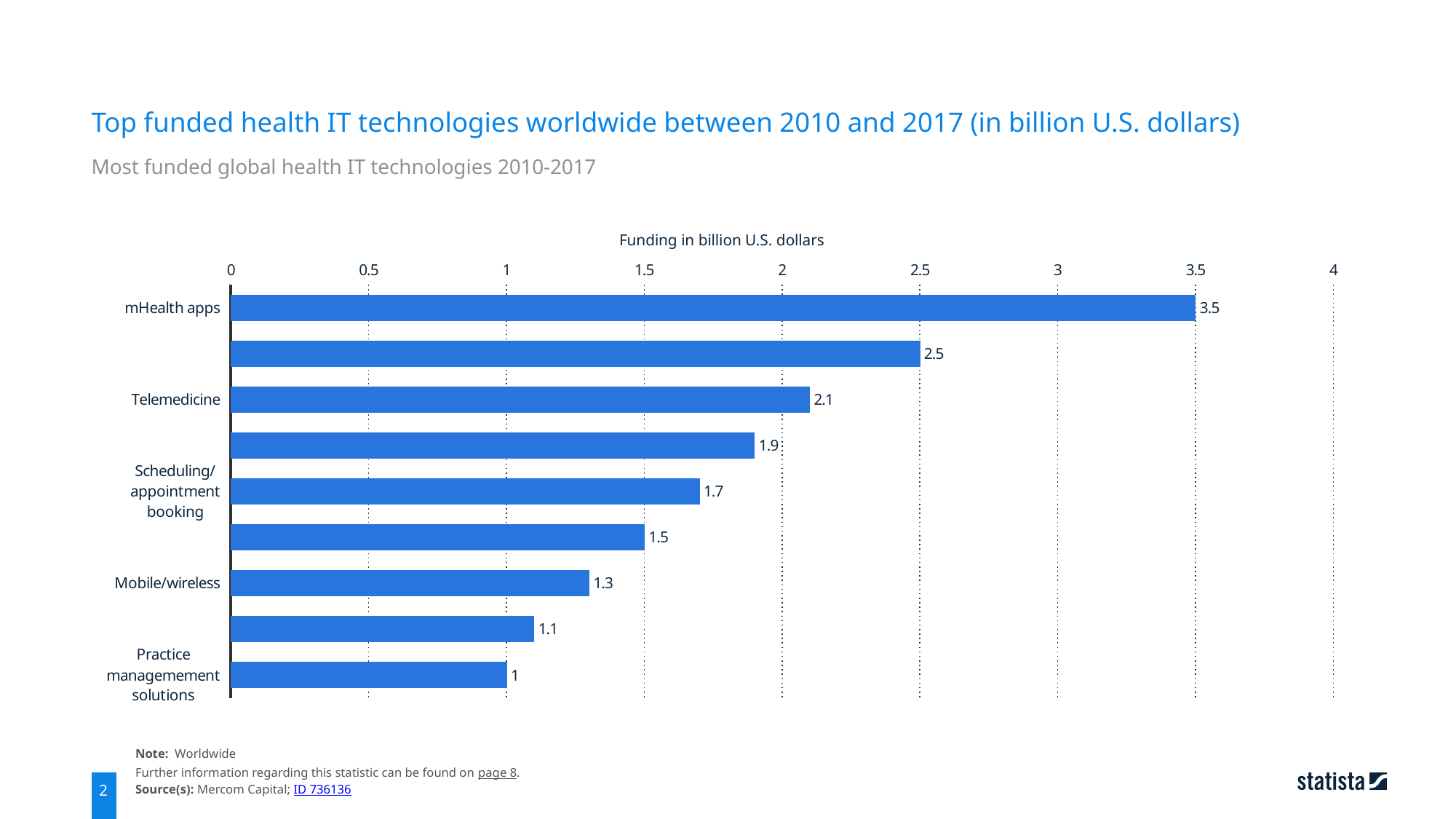
What is the title of the chart's value axis? Funding in billion U.S. dollars Which category has the highest funding? mHealth apps What is the funding value for mHealth apps? 3.5 What is the funding value for Practice management solutions? 1 What is the funding value for Scheduling/appointment booking? 1.7 Which has higher funding, Telemedicine or Mobile/wireless? Telemedicine What is the difference in funding between mHealth apps and Telemedicine? 1.4 Which category has the lowest funding? Practice management solutions How many bars are plotted in the chart? 9 What is the funding value for Telemedicine? 2.1 What is the funding value for Mobile/wireless? 1.3 What kind of chart is shown on the slide? Bar chart